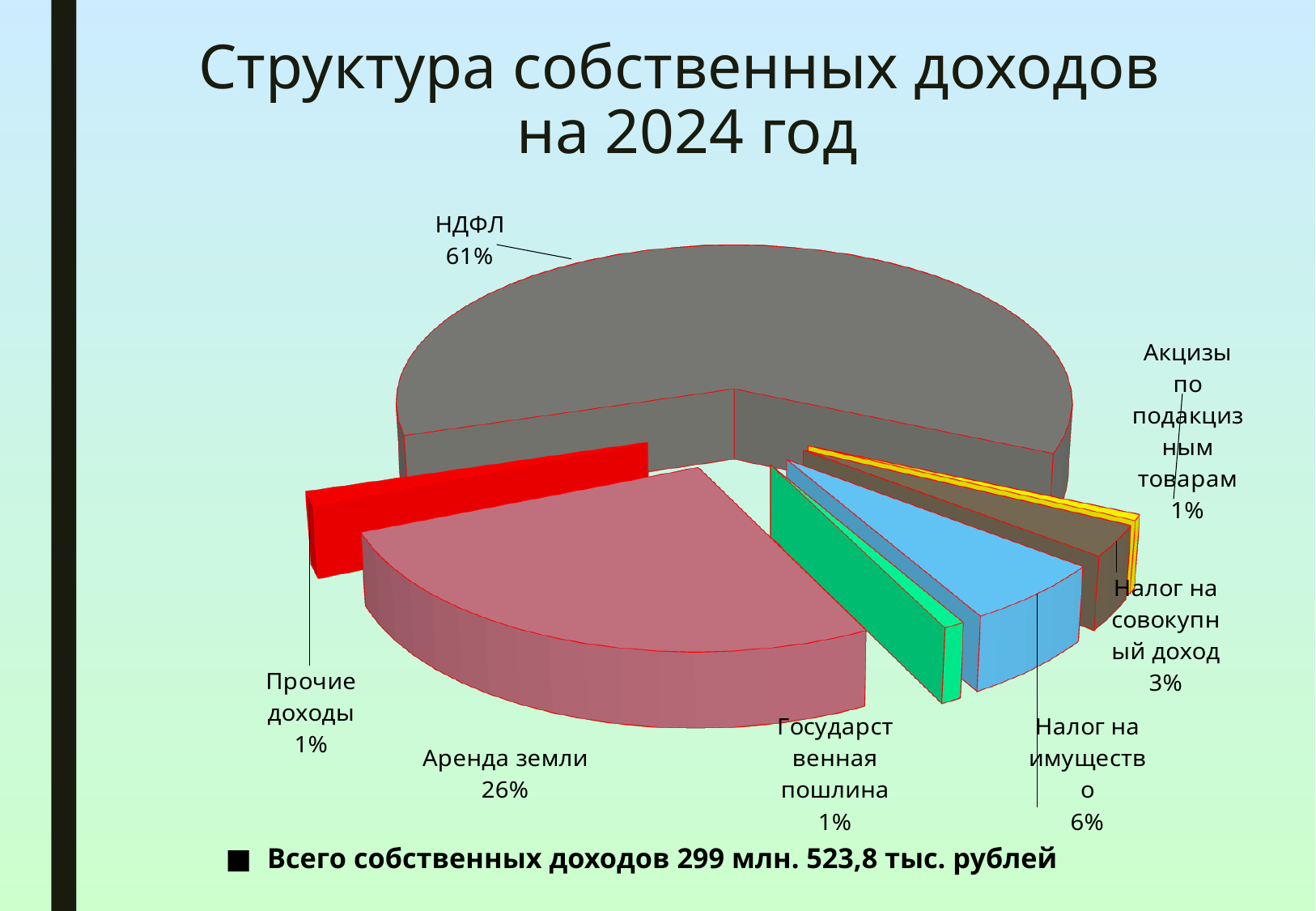
Какого типа диаграмма показана на слайде? Круговая диаграмма Как называется диаграмма на слайде? Структура собственных доходов на 2024 год Какая категория имеет наибольшую долю в структуре собственных доходов на 2024 год? НДФЛ Сколько категорий на диаграмме имеют долю 1%? 3 Какова общая сумма собственных доходов, указанная на слайде? 299 млн. 523,8 тыс. рублей Что больше: доля налога на имущество или доля налога на совокупный доход? Налог на имущество Сколько категорий показано на диаграмме структуры собственных доходов на 2024 год? 7 Какую долю занимает налог на совокупный доход? 3% Какая доля приходится на налог на имущество? 6% Какую долю занимает НДФЛ на диаграмме «Структура собственных доходов на 2024 год»? 61% Какую долю составляет аренда земли в структуре собственных доходов на 2024 год? 26% На сколько процентных пунктов доля НДФЛ больше доли аренды земли? 35